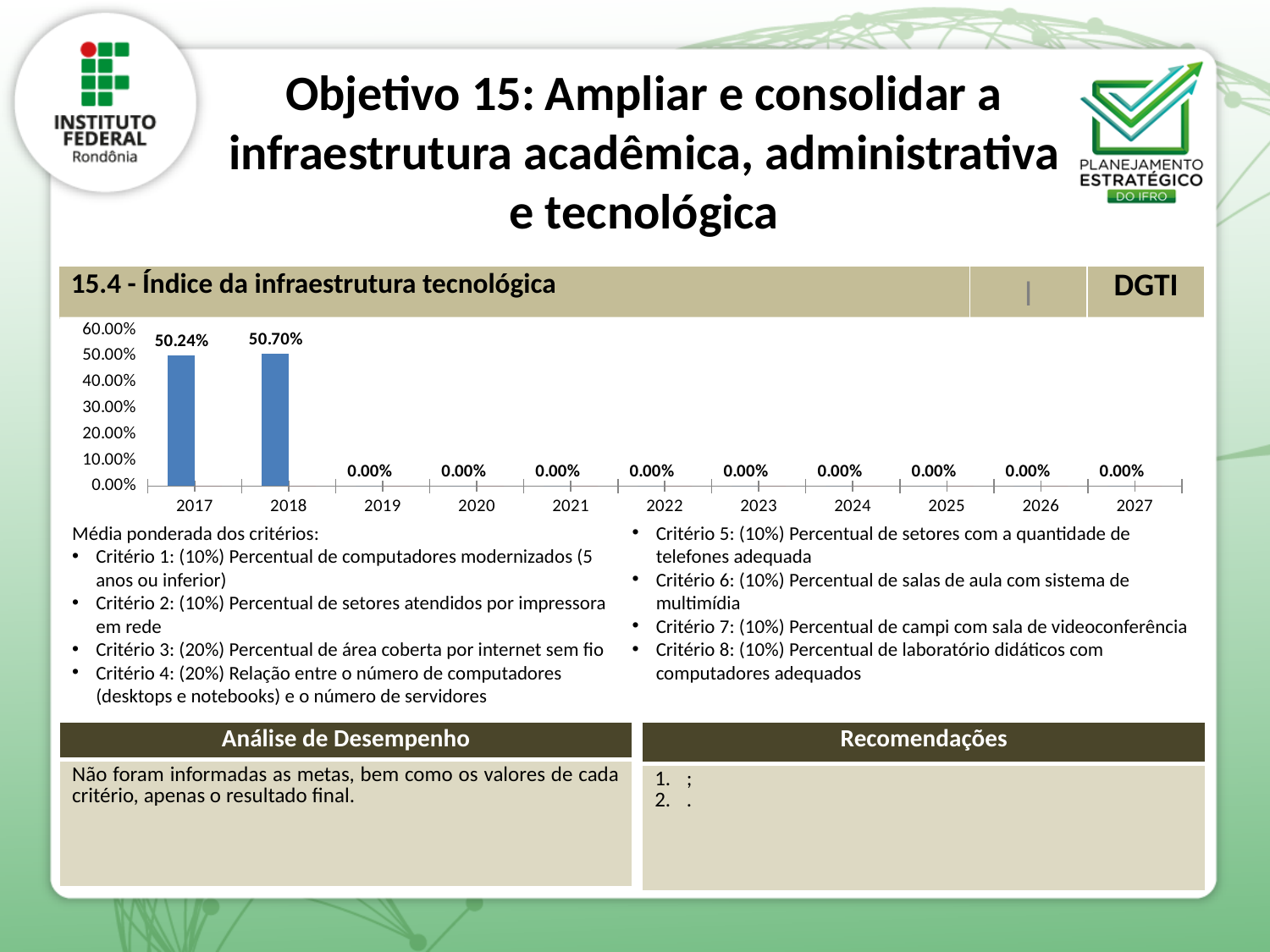
How many years are shown on the x axis? 11 Which is larger, the value for 2017 or the value for 2018? 2018 What is the value for 2022? 0.00% What is the title of the indicator shown above the chart? 15.4 - Índice da infraestrutura tecnológica What is the highest value shown on the y axis? 60.00% What kind of chart is shown on the slide? bar chart What is the value for 2017? 50.24% How many years have a value of 0.00%? 9 Is the value for 2017 greater or less than 40.00%? greater What is the difference between the values for 2018 and 2017? 0.46% What is the value for 2018? 50.70% Which year has the highest value? 2018